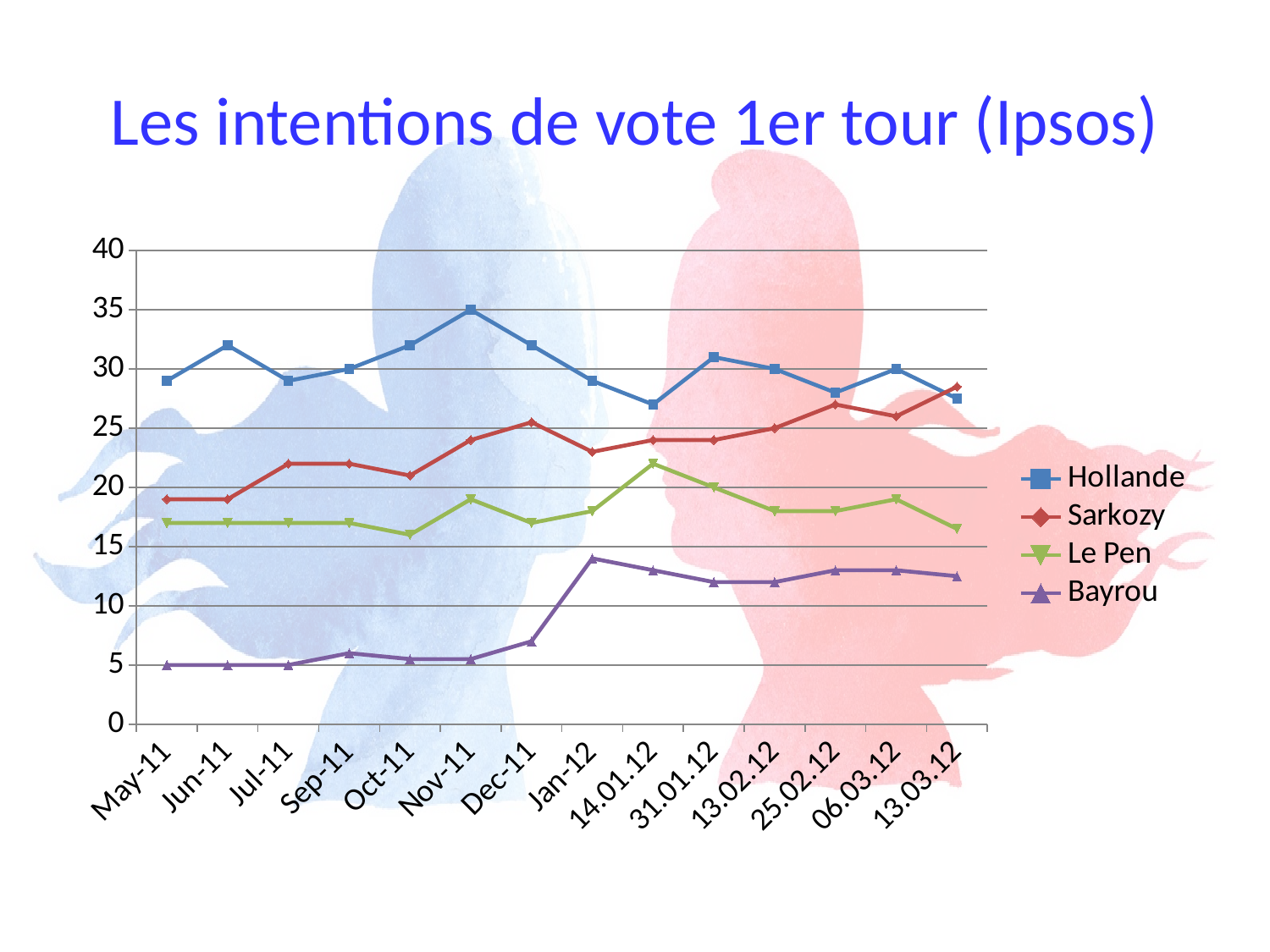
What is the title of the chart? Les intentions de vote 1er tour (Ipsos) Which is larger at Jan-12, the value for Le Pen or the value for Bayrou? Le Pen How many series does the legend list? 4 What is the value for Bayrou at May-11? 5 How many dates are shown along the x axis? 14 What kind of chart is shown on the slide? line chart Is the value for Bayrou at Jan-12 greater or less than 10? greater What is the value for Le Pen at 31.01.12? 20 At which date does Sarkozy reach his highest value? 13.03.12 Is the value for Le Pen at Oct-11 greater or less than 20? less What is the value for Hollande at Nov-11? 35 At which date does Hollande reach his highest value? Nov-11